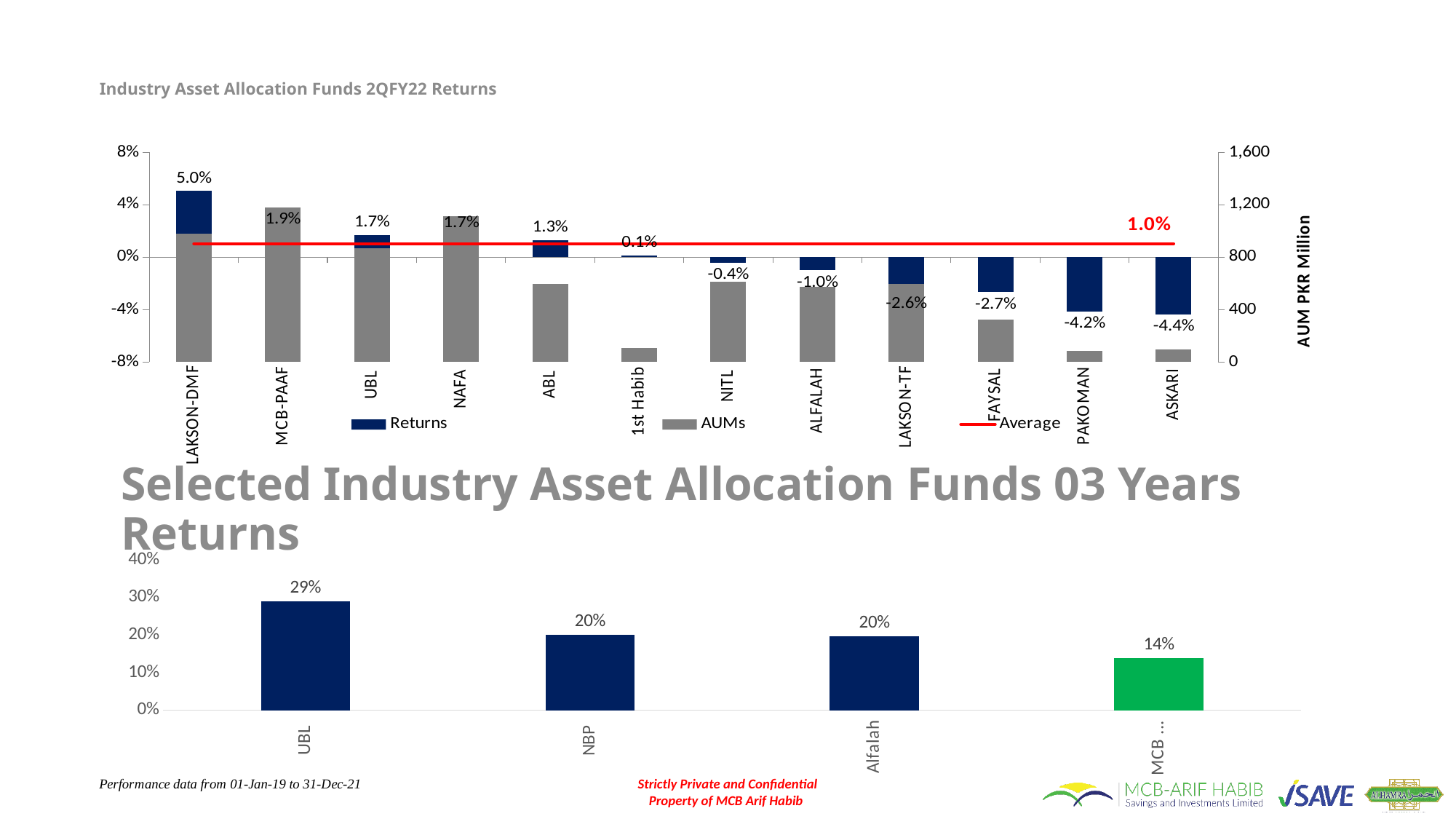
In the 'Industry Asset Allocation Funds 2QFY22 Returns' chart, how many entries does the legend list? 3 In the 'Industry Asset Allocation Funds 2QFY22 Returns' chart, how many funds are shown on the x axis? 12 In the 'Selected Industry Asset Allocation Funds 03 Years Returns' chart, which fund has the lowest return? MCB In the 'Industry Asset Allocation Funds 2QFY22 Returns' chart, which fund has the lowest return? ASKARI In the 'Industry Asset Allocation Funds 2QFY22 Returns' chart, what is the return for LAKSON-DMF? 5.0% In the 'Industry Asset Allocation Funds 2QFY22 Returns' chart, what is the difference between the returns of LAKSON-DMF and MCB-PAAF? 3.1% In the 'Industry Asset Allocation Funds 2QFY22 Returns' chart, what is the return for PAKOMAN? -4.2% In the 'Industry Asset Allocation Funds 2QFY22 Returns' chart, which fund has the highest return? LAKSON-DMF In the 'Industry Asset Allocation Funds 2QFY22 Returns' chart, what value does the Average line show? 1.0% In the 'Selected Industry Asset Allocation Funds 03 Years Returns' chart, what is the 3-year return for UBL? 29% What kind of chart is the 'Selected Industry Asset Allocation Funds 03 Years Returns' chart? Bar chart In the 'Industry Asset Allocation Funds 2QFY22 Returns' chart, is the AUM for MCB-PAAF greater or less than 800 PKR Million? greater